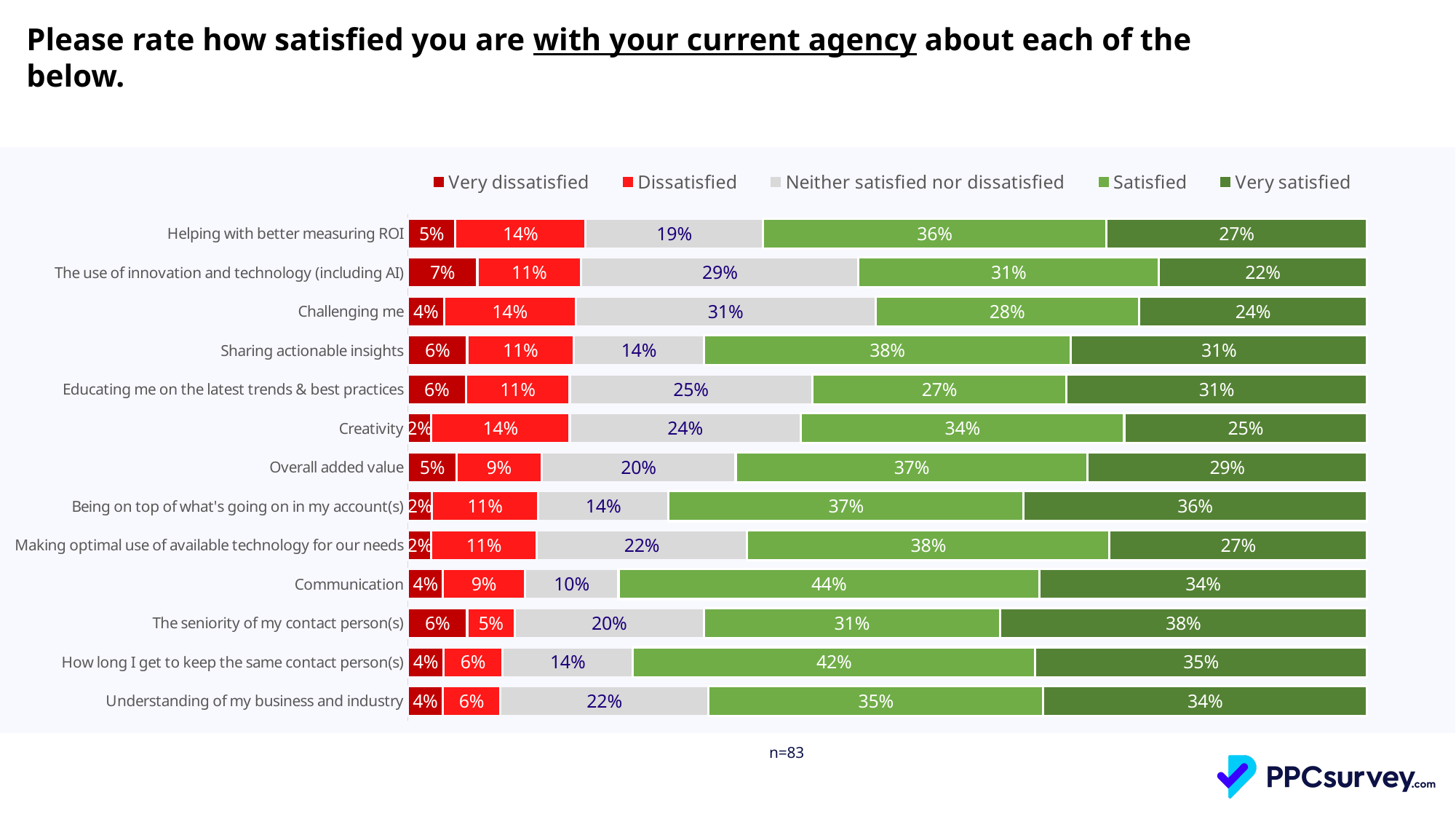
What percentage of respondents are 'Satisfied' with Communication? 44% Which category has the lowest 'Neither satisfied nor dissatisfied' percentage? Communication What is the total of the stacked bar for 'Sharing actionable insights'? 100% How many series does the legend list? 5 Which category has the highest 'Very dissatisfied' percentage? The use of innovation and technology (including AI) For Communication, what is the difference between the 'Satisfied' and 'Very satisfied' percentages? 10 percentage points What is the 'Neither satisfied nor dissatisfied' value for 'Challenging me'? 31% Which category has the highest 'Satisfied' percentage? Communication Which is larger: the 'Very satisfied' value for 'Sharing actionable insights' or for 'Creativity'? Sharing actionable insights How many categories (rows) are shown in the chart? 13 What is the 'Very satisfied' value for 'The seniority of my contact person(s)'? 38% What type of chart is shown on the slide? Stacked bar chart